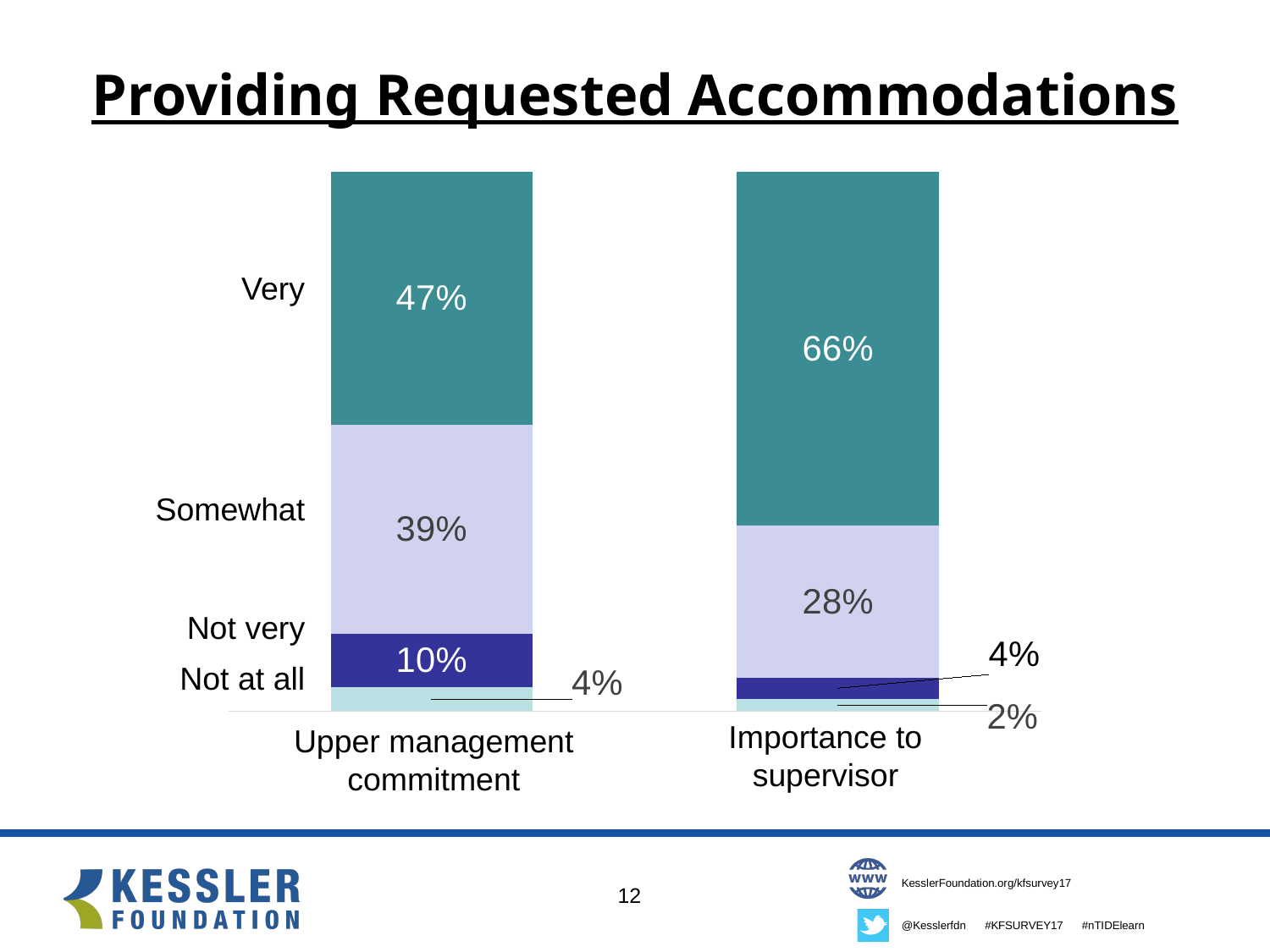
Which response level is the smallest segment in the Upper management commitment bar? Not at all What is the "Not very" value for Upper management commitment? 10% What type of chart is shown on the slide? Stacked bar chart How many response levels (series) are shown in the stacked bars? 4 Which response level is the largest segment in the Importance to supervisor bar? Very What is the difference between the "Somewhat" values for Upper management commitment and Importance to supervisor? 11% Which category has the higher "Very" value, Upper management commitment or Importance to supervisor? Importance to supervisor What is the "Not at all" value for Importance to supervisor? 2% What is the "Somewhat" value for Importance to supervisor? 28% What is the total of the stacked bar for Upper management commitment? 100% What percentage of respondents rated upper management commitment as "Very" important? 47% What is the difference between the "Very" values for Importance to supervisor and Upper management commitment? 19%